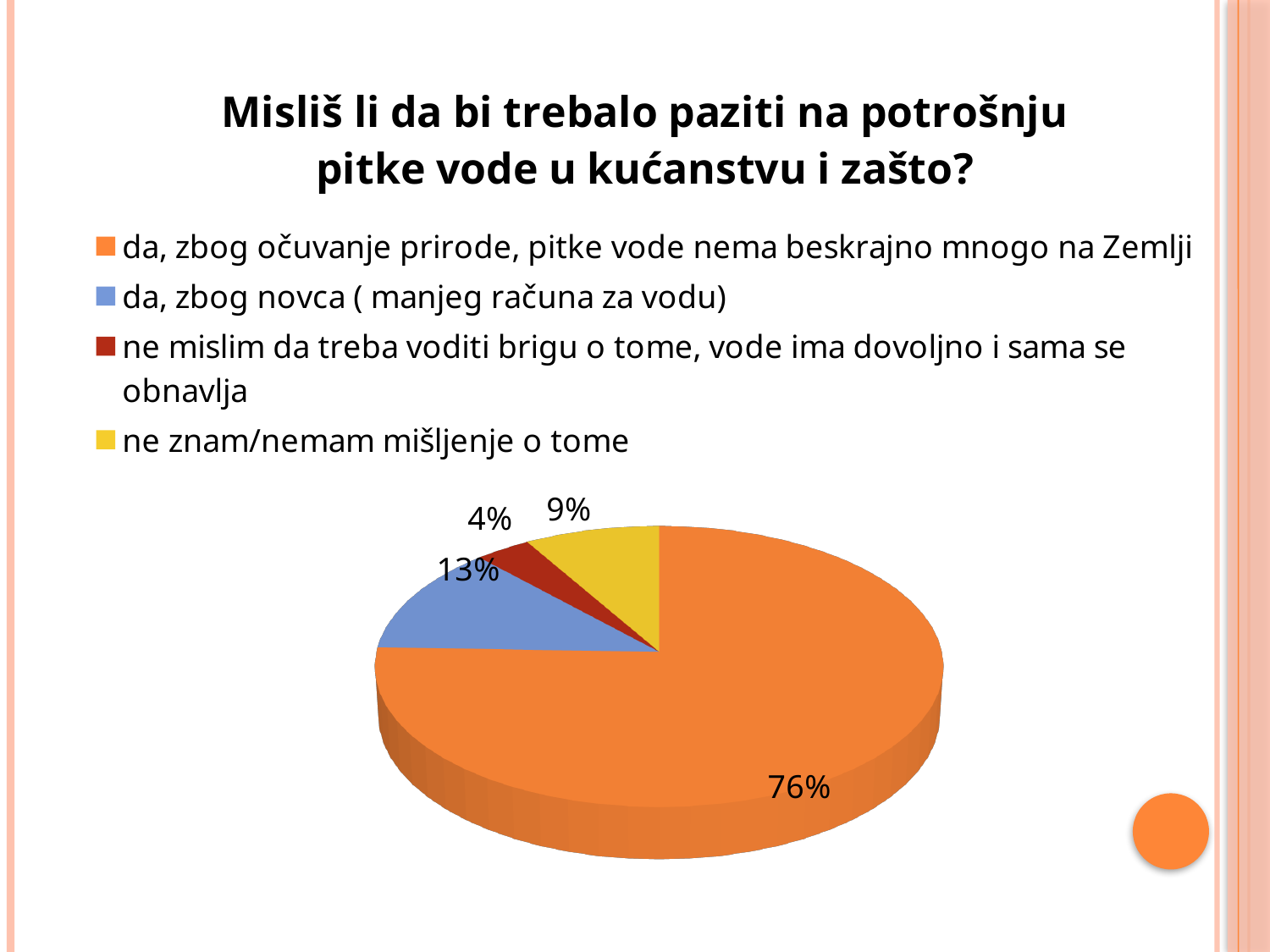
What share of the pie is labelled for "ne mislim da treba voditi brigu o tome, vode ima dovoljno i sama se obnavlja"? 4% What share of the pie is labelled for "da, zbog novca ( manjeg računa za vodu)"? 13% Which category has the largest slice of the pie? da, zbog očuvanje prirode, pitke vode nema beskrajno mnogo na Zemlji What share of the pie is labelled for "da, zbog očuvanje prirode, pitke vode nema beskrajno mnogo na Zemlji"? 76% Which category has the smallest slice of the pie? ne mislim da treba voditi brigu o tome, vode ima dovoljno i sama se obnavlja What kind of chart is shown on the slide? pie chart Which slice is larger: "da, zbog novca ( manjeg računa za vodu)" or "ne znam/nemam mišljenje o tome"? da, zbog novca ( manjeg računa za vodu) What share of the pie is labelled for "ne znam/nemam mišljenje o tome"? 9% What is the difference in percentage points between the "da, zbog novca" slice and the "ne znam/nemam mišljenje o tome" slice? 4 What colour is the slice for "ne znam/nemam mišljenje o tome"? yellow What is the title of the chart? Misliš li da bi trebalo paziti na potrošnju pitke vode u kućanstvu i zašto? How many categories does the pie chart have? 4